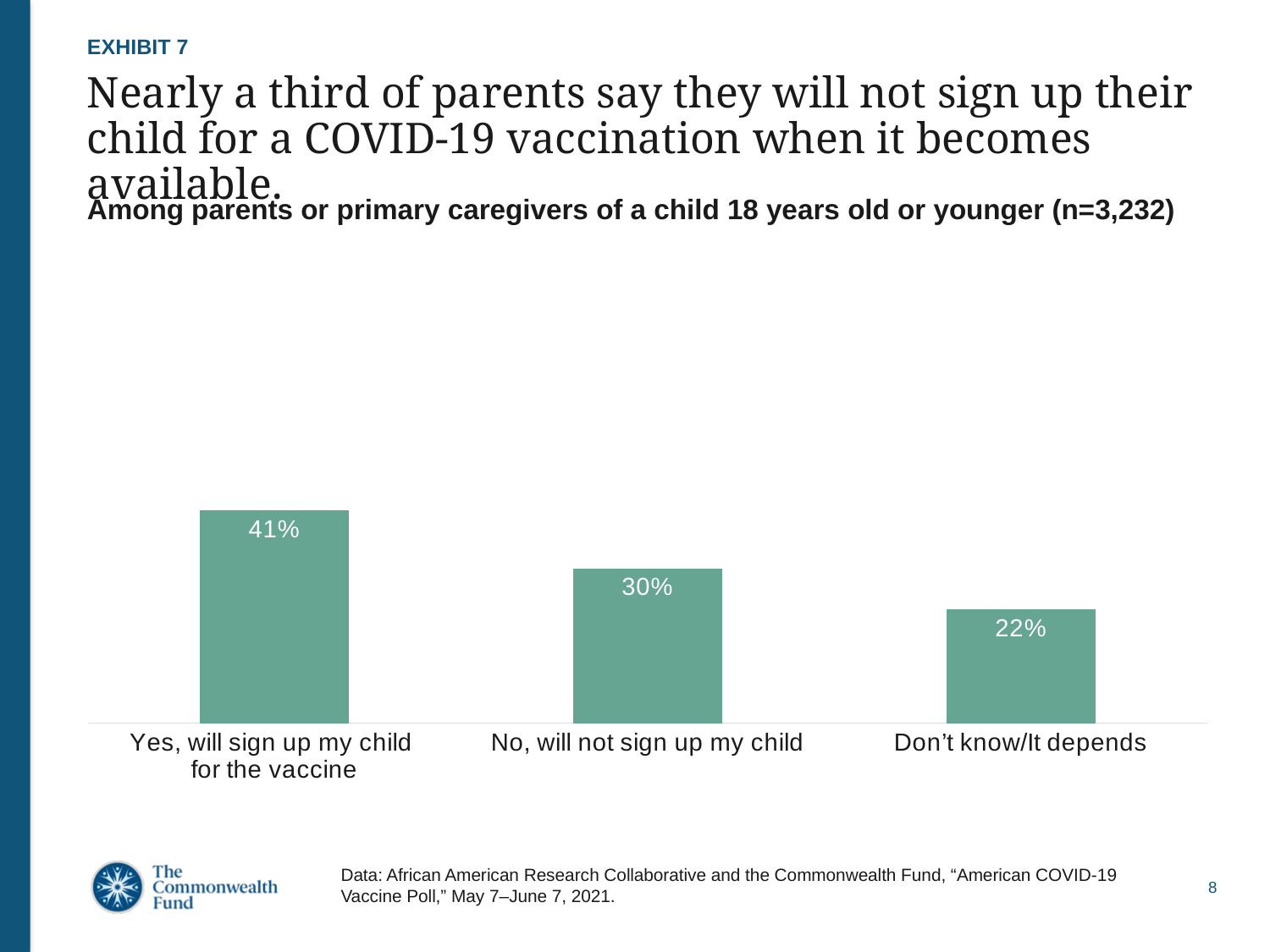
Which category has the highest value? Yes, will sign up my child for the vaccine Do the values rise or fall from left to right across the categories? Fall What is the sample size (n) stated in the chart subtitle? 3,232 Which is larger: the value for 'No, will not sign up my child' or for 'Don't know/It depends'? No, will not sign up my child What is the value for the 'Don't know/It depends' category? 22% What percentage of parents say they will sign up their child for the vaccine? 41% Which category has the lowest value? Don't know/It depends What is the difference between the 'Yes, will sign up my child for the vaccine' and 'No, will not sign up my child' values? 11 percentage points What kind of chart is shown on the slide? Bar chart What is the difference between the 'No, will not sign up my child' and 'Don't know/It depends' values? 8 percentage points How many categories are shown in the chart? 3 What percentage of parents say they will not sign up their child? 30%